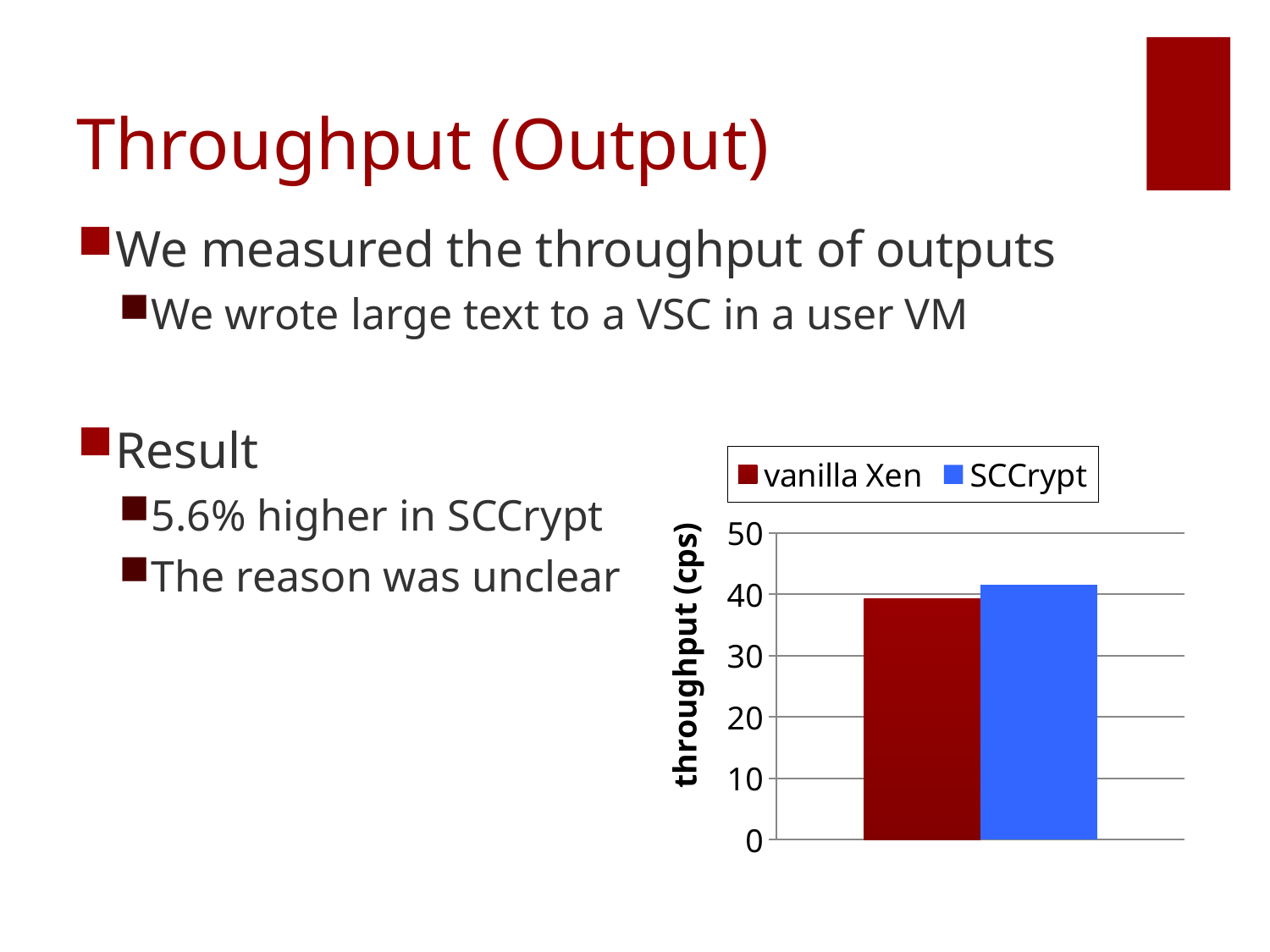
Is the throughput value for SCCrypt greater or less than 50? less How many series does the chart's legend list? 2 What are the two series named in the chart's legend? vanilla Xen and SCCrypt Which series has the lowest bar in the chart? vanilla Xen How many bars are plotted in the chart? 2 What is the label on the chart's vertical axis? throughput (cps) What kind of chart is shown on the slide? bar chart Which series has the highest bar in the chart? SCCrypt Is the throughput value for vanilla Xen greater or less than 30? greater Which has the higher throughput in the chart, vanilla Xen or SCCrypt? SCCrypt